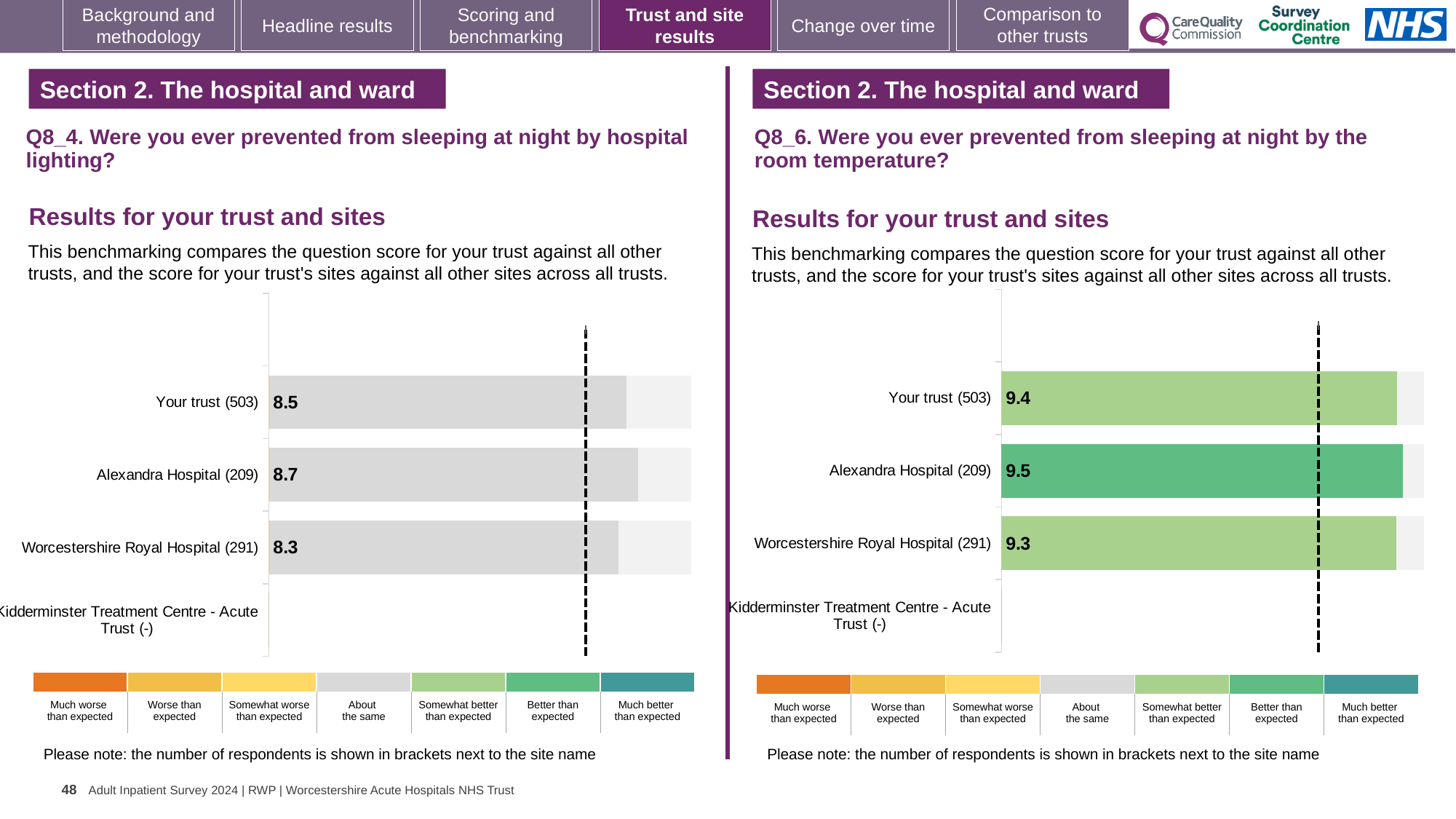
In the Q8_6 chart (room temperature), what benchmark category does the colour of the Alexandra Hospital (209) bar indicate? Better than expected In the Q8_6 chart (room temperature), what is the score for Your trust (503)? 9.4 In the Q8_6 chart (room temperature), which has the higher score: Your trust (503) or Alexandra Hospital (209)? Alexandra Hospital (209) In the Q8_4 chart (hospital lighting), what is the score for Your trust (503)? 8.5 In the Q8_4 chart (hospital lighting), what is the difference between the scores for Alexandra Hospital (209) and Worcestershire Royal Hospital (291)? 0.4 In the Q8_4 chart (hospital lighting), which site has the highest score? Alexandra Hospital (209) In the Q8_6 chart (room temperature), what is the score for Alexandra Hospital (209)? 9.5 In the Q8_6 chart (room temperature), what is the score for Worcestershire Royal Hospital (291)? 9.3 In the Q8_6 chart (room temperature), which site has the lowest score? Worcestershire Royal Hospital (291) In the Q8_4 chart (hospital lighting), what is the score for Alexandra Hospital (209)? 8.7 What kind of chart is used in the Q8_6 chart (room temperature)? Bar chart In the Q8_4 chart (hospital lighting), what is the score for Worcestershire Royal Hospital (291)? 8.3